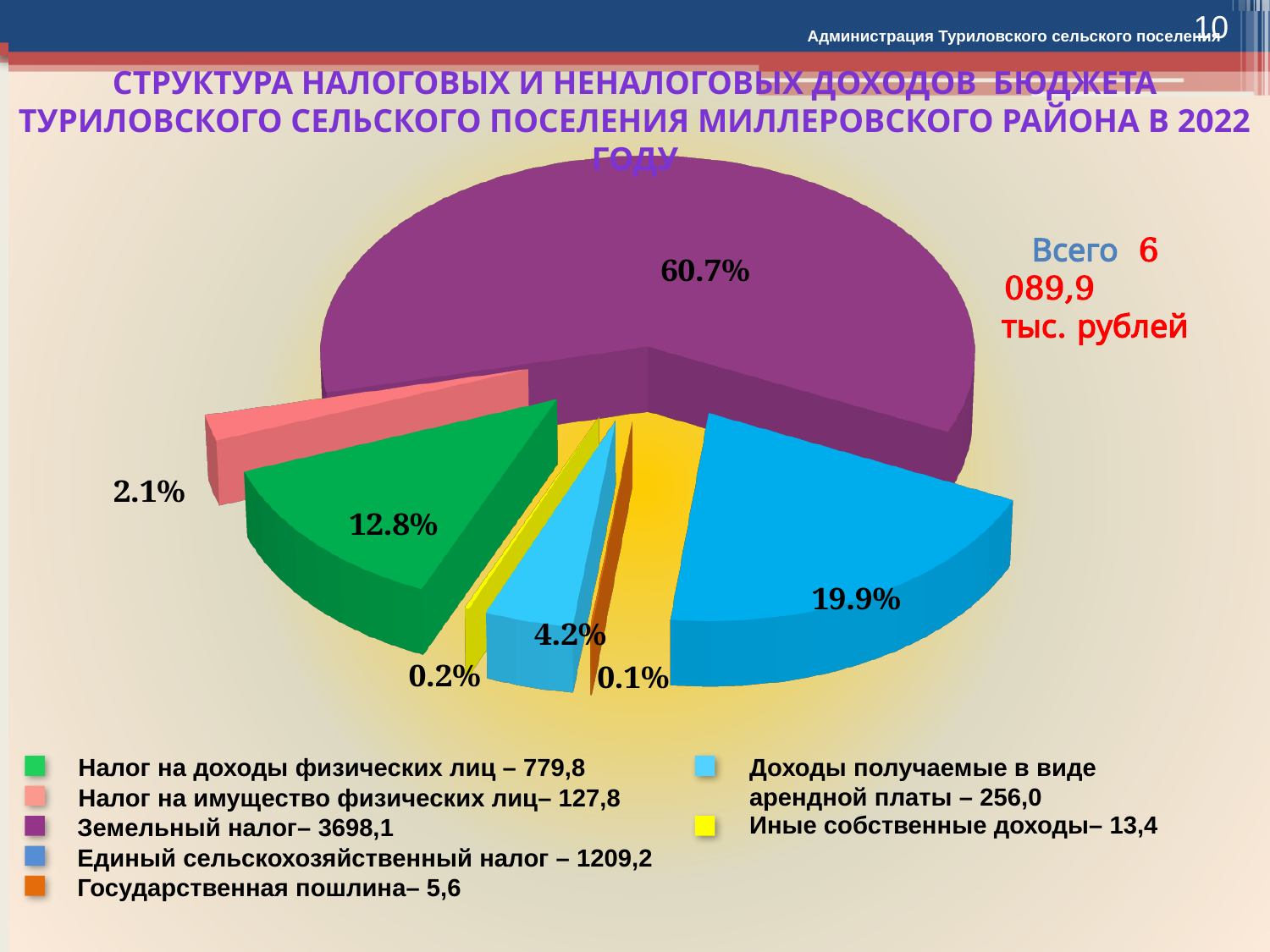
Which category has the smallest share of the pie? Государственная пошлина What share of the pie does the purple slice (Земельный налог) represent? 60.7% Which category has the largest share of the pie? Земельный налог What share of the pie does the green slice (Налог на доходы физических лиц) represent? 12.8% What kind of chart is shown on the slide? pie chart What is the difference in percentage points between the largest slice (60.7%) and the second largest slice (19.9%)? 40.8 According to the legend, what is the value for Единый сельскохозяйственный налог? 1209,2 According to the legend, what is the value for Земельный налог? 3698,1 How many slices does the pie chart have? 7 Which is larger: the share for Налог на имущество физических лиц or the share for Доходы получаемые в виде арендной платы? Доходы получаемые в виде арендной платы What total amount (Всего) is stated next to the pie chart? 6 089,9 тыс. рублей What share of the pie does the blue slice (Единый сельскохозяйственный налог) represent? 19.9%